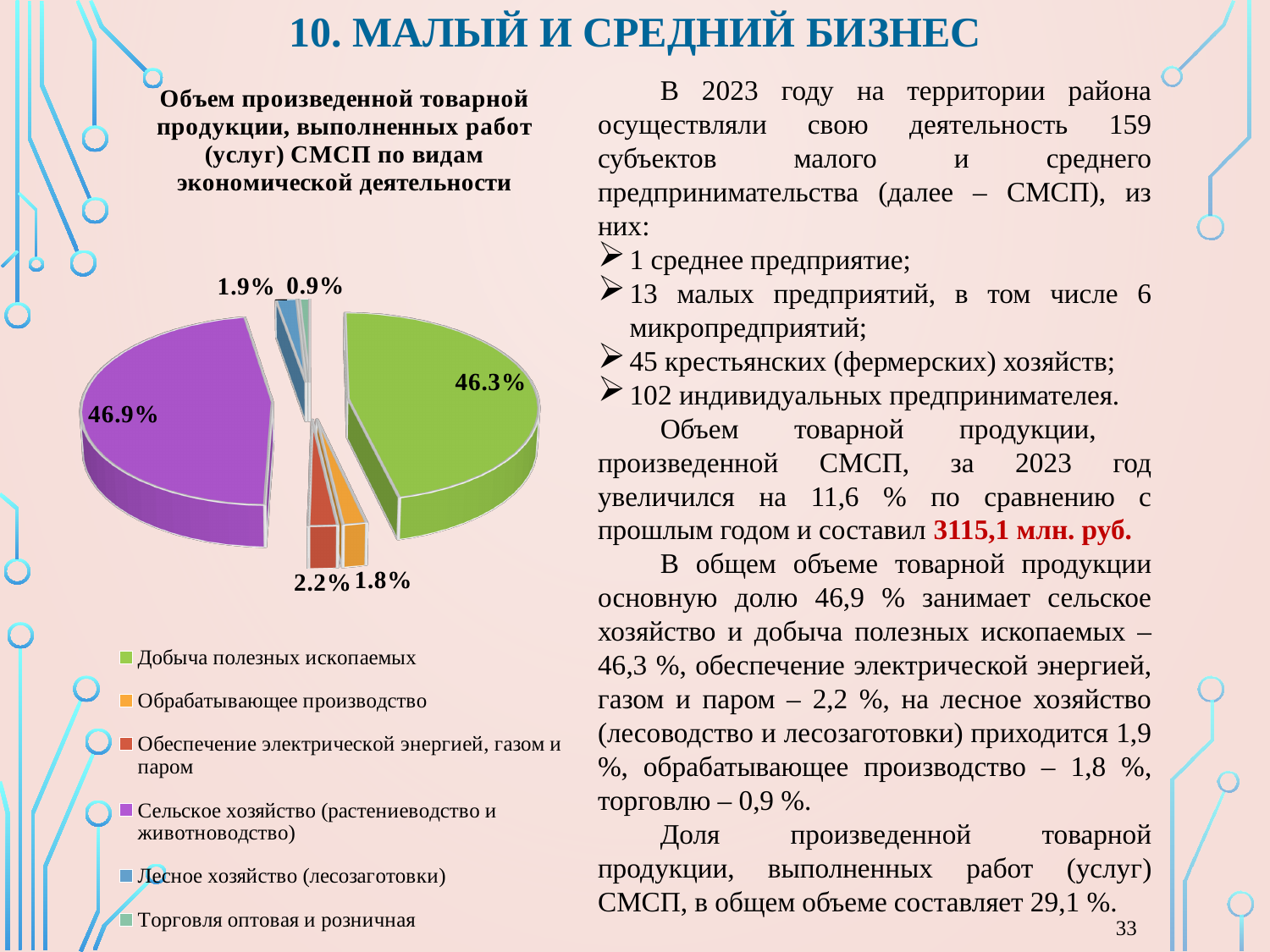
How many categories does the pie chart have? 6 What share of the pie does Добыча полезных ископаемых have? 46.3% Which is larger: the share of Обеспечение электрической энергией, газом и паром or the share of Лесное хозяйство (лесозаготовки)? Обеспечение электрической энергией, газом и паром What share of the pie does Сельское хозяйство (растениеводство и животноводство) have? 46.9% Which category has the largest share of the pie? Сельское хозяйство (растениеводство и животноводство) Which category has the smallest share of the pie? Торговля оптовая и розничная What share of the pie does Обрабатывающее производство have? 1.8% What share of the pie does Торговля оптовая и розничная have? 0.9% What is the difference between the shares of Сельское хозяйство and Добыча полезных ископаемых? 0.6% What colour is the slice for Сельское хозяйство (растениеводство и животноводство)? purple What kind of chart is shown on the slide? pie chart What share of the pie does Обеспечение электрической энергией, газом и паром have? 2.2%